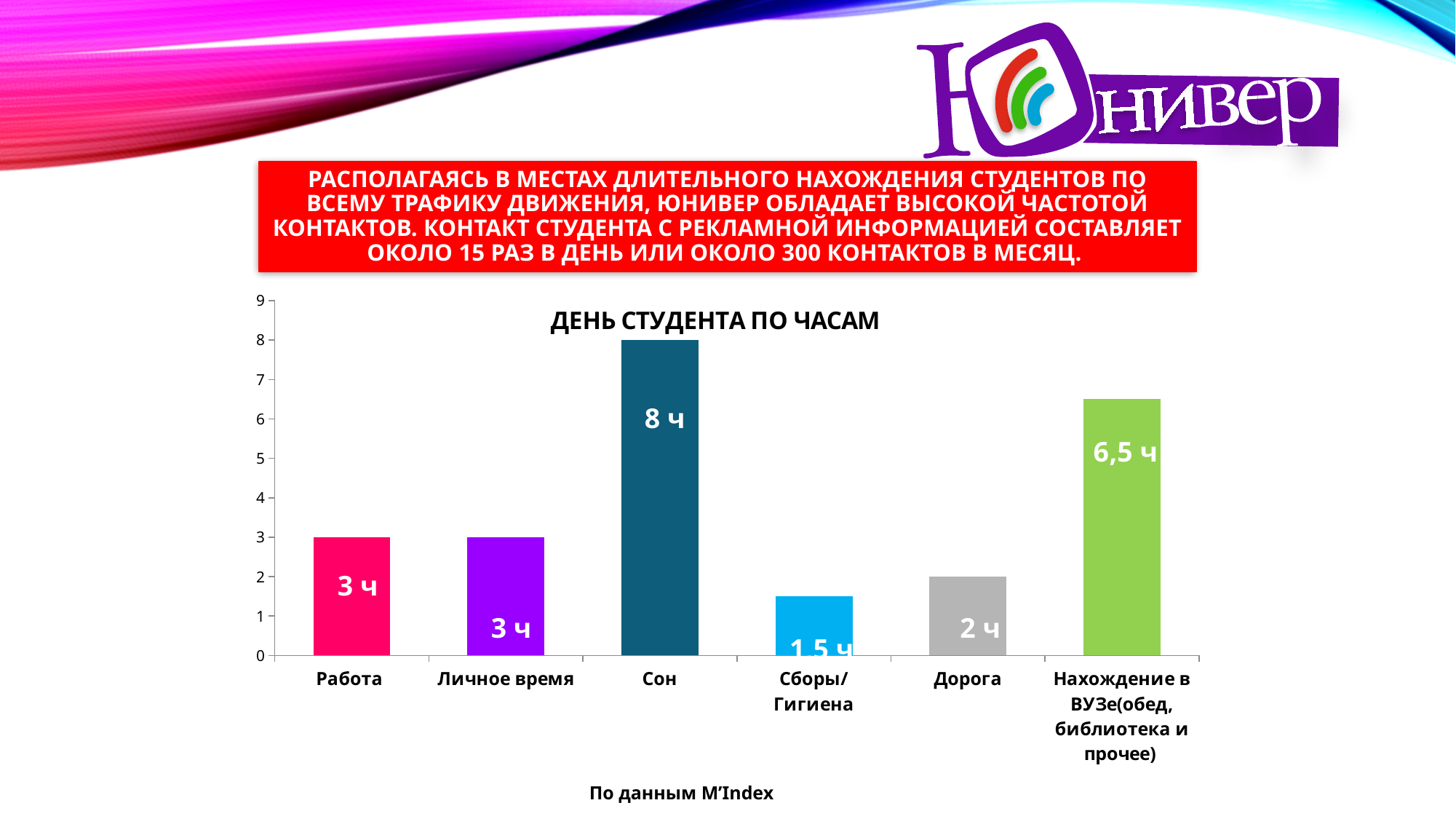
How many categories are shown in the chart? 6 What is the value for Сон in the chart 'ДЕНЬ СТУДЕНТА ПО ЧАСАМ'? 8 ч Which category has the highest value in the chart? Сон Which is larger: the value for Работа or the value for Дорога? Работа What is the title of the chart? ДЕНЬ СТУДЕНТА ПО ЧАСАМ What is the value for Нахождение в ВУЗе(обед, библиотека и прочее)? 6,5 ч What type of chart is shown on the slide? Bar chart How many hours are shown for Дорога? 2 ч Is the value for Нахождение в ВУЗе greater or less than 6? greater Which category has the lowest value in the chart? Сборы/Гигиена What is the value for Сборы/Гигиена? 1,5 ч What is the difference in hours between Сон and Нахождение в ВУЗе? 1,5 ч